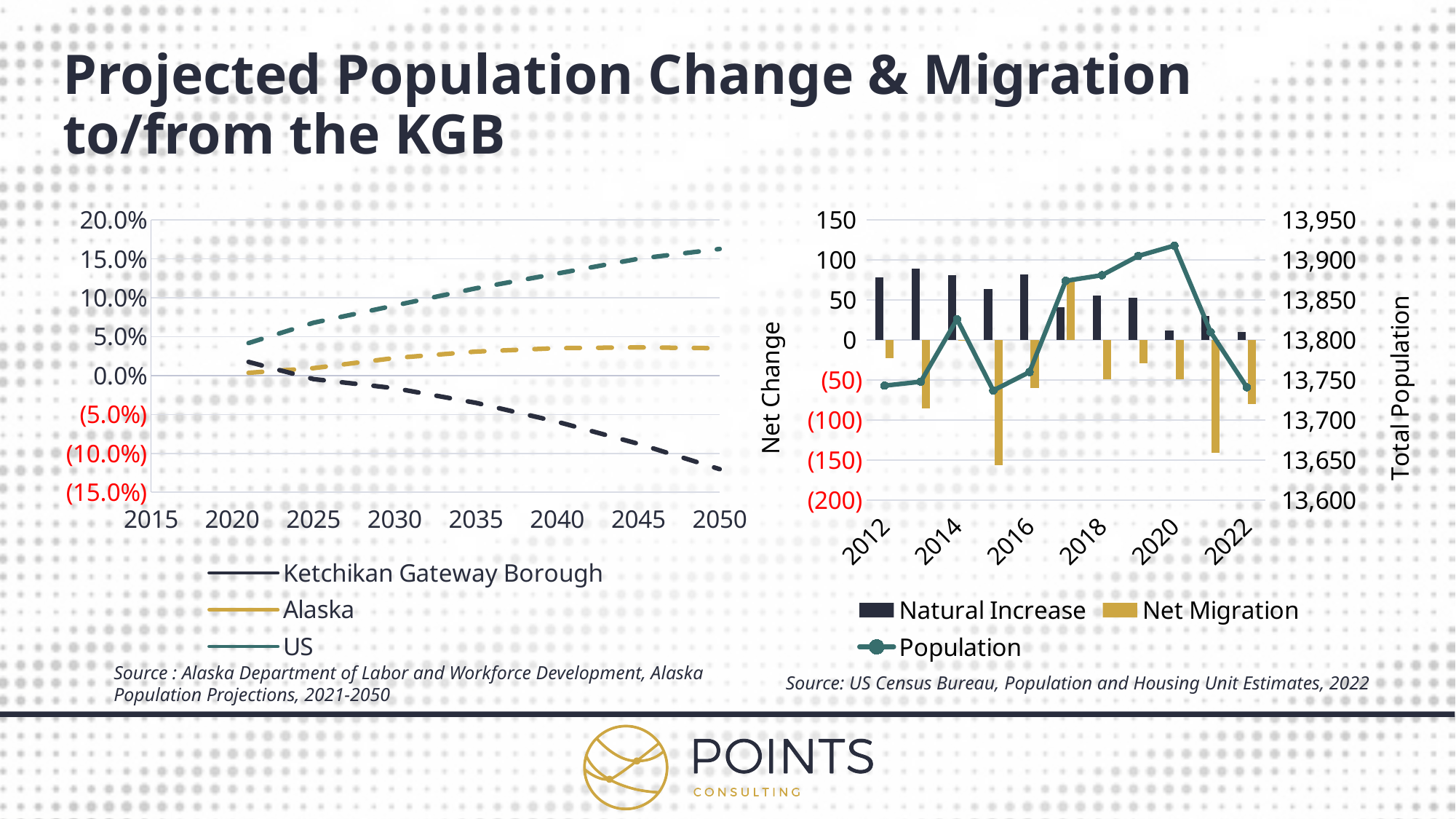
On the left chart, is the value for US in 2050 greater or less than 10.0%? greater On the right chart, which is larger, the Natural Increase for 2013 or for 2022? 2013 On the left chart, how many series does the legend list? 3 On the right chart, how many series does the legend list? 3 On the right chart, what is the label of the right-hand vertical axis? Total Population On the left chart, does the Ketchikan Gateway Borough line rise or fall from 2021 to 2050? fall On the right chart, is the Population value for 2020 greater or less than 13,900? greater On the left chart, which series has the highest value in 2050? US On the right chart, is the Net Migration value for 2016 greater or less than (100)? greater On the left chart, does the US line rise or fall from 2021 to 2050? rise On the right chart, in which year does the Population line reach its highest point? 2020